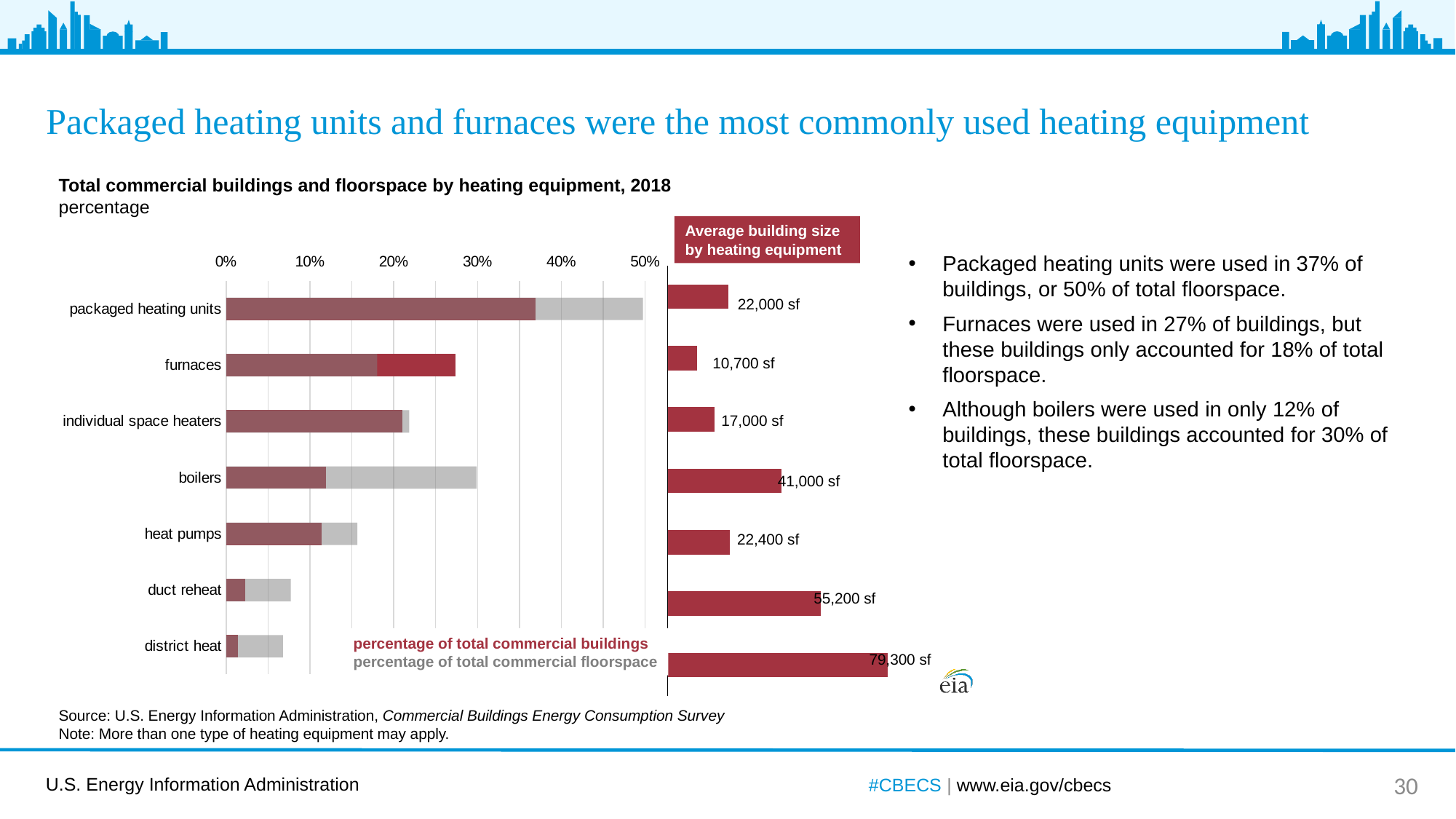
How many heating equipment categories are shown on the left chart? 7 On the 'Average building size by heating equipment' chart, what is the average building size for boilers? 41,000 sf On the left chart, which heating equipment has the highest percentage of total commercial buildings? packaged heating units On the left chart, is the percentage of total commercial floorspace for packaged heating units greater or less than 40%? greater On the 'Average building size by heating equipment' chart, which has a larger average building size, boilers or heat pumps? boilers How many series does the legend of the left chart list? 2 On the 'Average building size by heating equipment' chart, what is the difference in average building size between district heat and duct reheat? 24,100 sf On the left chart, what kind of chart is used to show the percentage of buildings and floorspace by heating equipment? bar chart On the left chart, is the percentage of total commercial buildings for duct reheat greater or less than 10%? less On the 'Average building size by heating equipment' chart, what is the average building size for furnaces? 10,700 sf On the left chart, is the percentage of total commercial buildings for boilers greater or less than 20%? less On the 'Average building size by heating equipment' chart, which heating equipment has the largest average building size? district heat